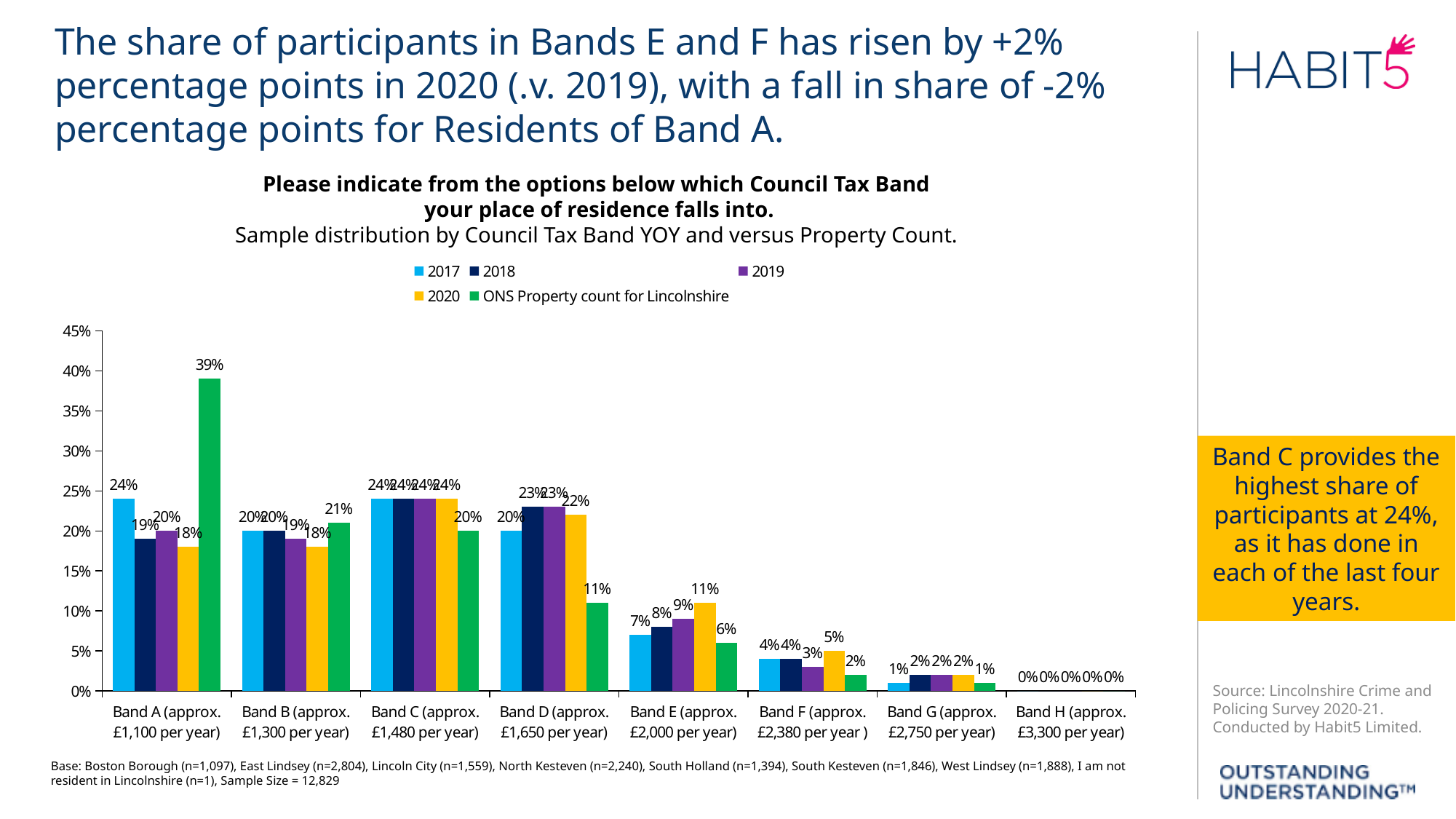
What is the difference between the 2017 and 2020 values for Band A? 6% How many council tax bands are shown on the x axis? 8 What is the ONS Property count for Lincolnshire value for Band A? 39% What is the 2019 value for Band F? 3% Which band has the highest ONS Property count for Lincolnshire value? Band A Which band has the highest 2020 value? Band C What is the 2017 value for Band D? 20% What is the 2020 value for Band E? 11% What is the difference between the 2020 value and the ONS Property count for Lincolnshire value for Band D? 11% Which is larger for Band E, the 2017 value or the 2020 value? 2020 How many series does the legend list? 5 What kind of chart is shown on the slide? Bar chart